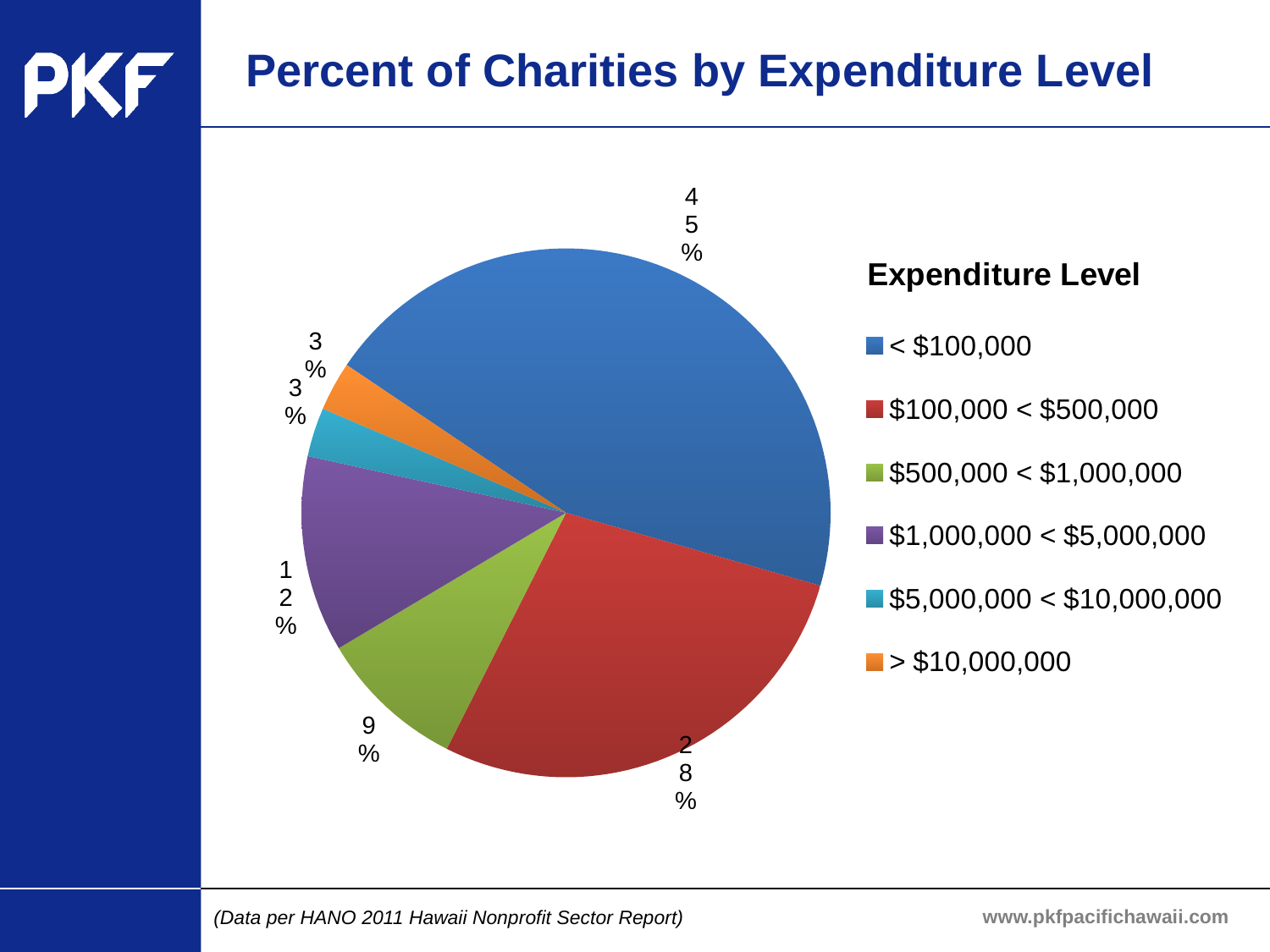
What percent of charities have an expenditure level of $1,000,000 < $5,000,000? 12% What colour is the slice for the > $10,000,000 expenditure level? Orange Which is larger: the share for $1,000,000 < $5,000,000 or the share for $500,000 < $1,000,000? $1,000,000 < $5,000,000 What percent of charities have an expenditure level of $500,000 < $1,000,000? 9% What is the title of the chart? Expenditure Level What percent of charities have an expenditure level of $100,000 < $500,000? 28% What is the difference in percentage points between the < $100,000 slice and the $100,000 < $500,000 slice? 17 How many expenditure level categories does the legend list? 6 What type of chart is shown on the slide? Pie chart What is the combined percentage of charities with expenditure levels of $5,000,000 < $10,000,000 and > $10,000,000? 6% Which expenditure level has the largest share of charities? < $100,000 What percent of charities have an expenditure level of < $100,000? 45%